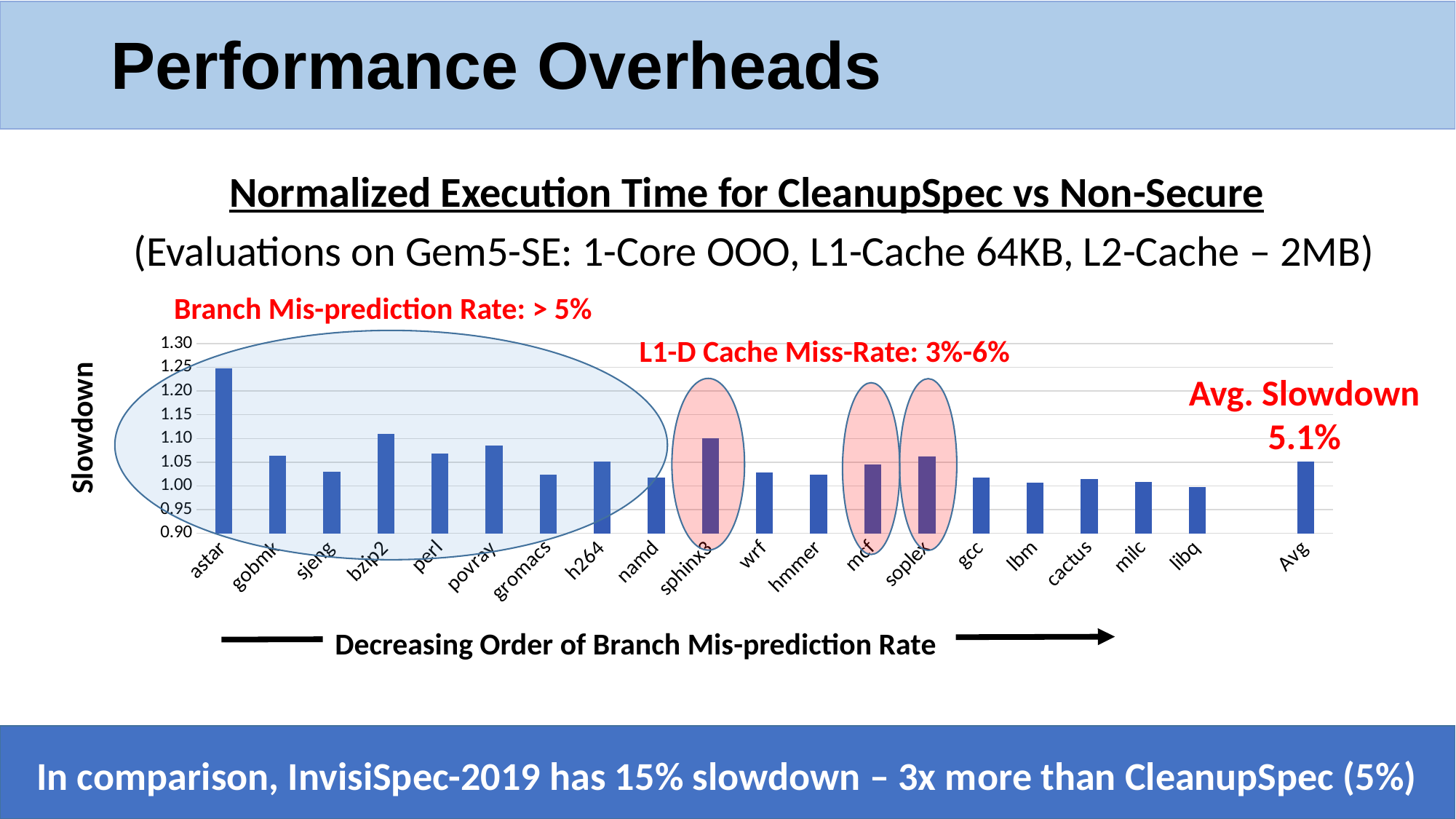
What kind of chart is shown on the slide? bar chart What is the label of the vertical axis of the chart? Slowdown Which category has the highest slowdown in the chart? astar Is the value for astar greater or less than 1.20? greater Is the value for sjeng greater or less than 1.05? less Is the value for sphinx3 greater or less than 1.05? greater Which has a larger slowdown, astar or bzip2? astar What average slowdown is annotated next to the chart? 5.1% How many bars are plotted in the chart, including Avg? 20 Which has a larger slowdown, bzip2 or gobmk? bzip2